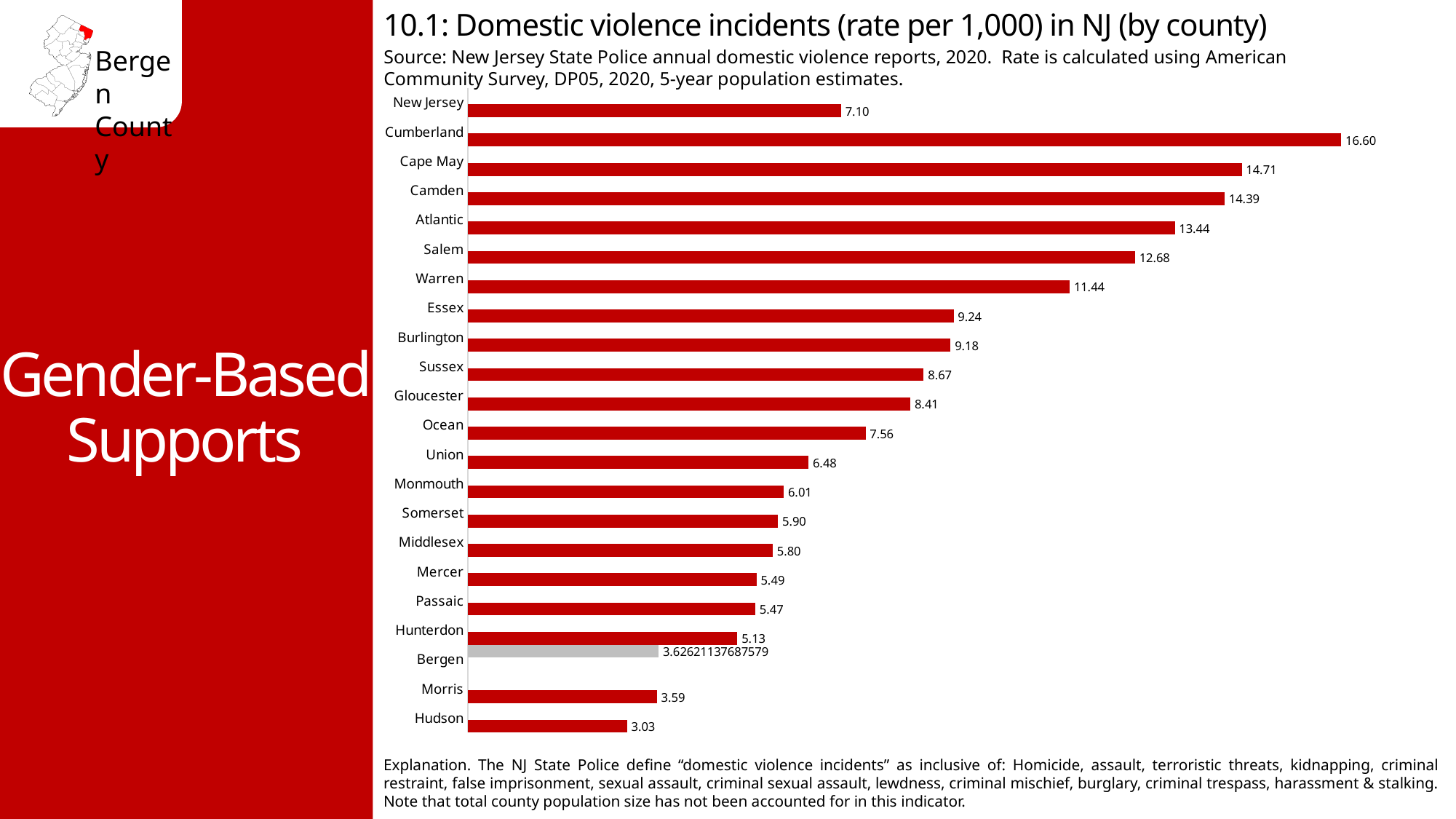
Which has a higher rate, Essex or Burlington? Essex Which county has the highest domestic violence incident rate? Cumberland Which county's bar is coloured grey instead of red? Bergen How many bars (categories) are shown in the chart? 22 What is the difference between the rates for Cumberland and Hudson? 13.57 What is the rate shown for Warren County? 11.44 Which county has the lowest domestic violence incident rate? Hudson What is the difference between the rates for Cape May and Camden? 0.32 What is the rate shown for Hudson County? 3.03 What is the domestic violence incident rate per 1,000 for Cumberland County? 16.60 What kind of chart is shown on the slide? Bar chart What is the rate shown for New Jersey overall? 7.10